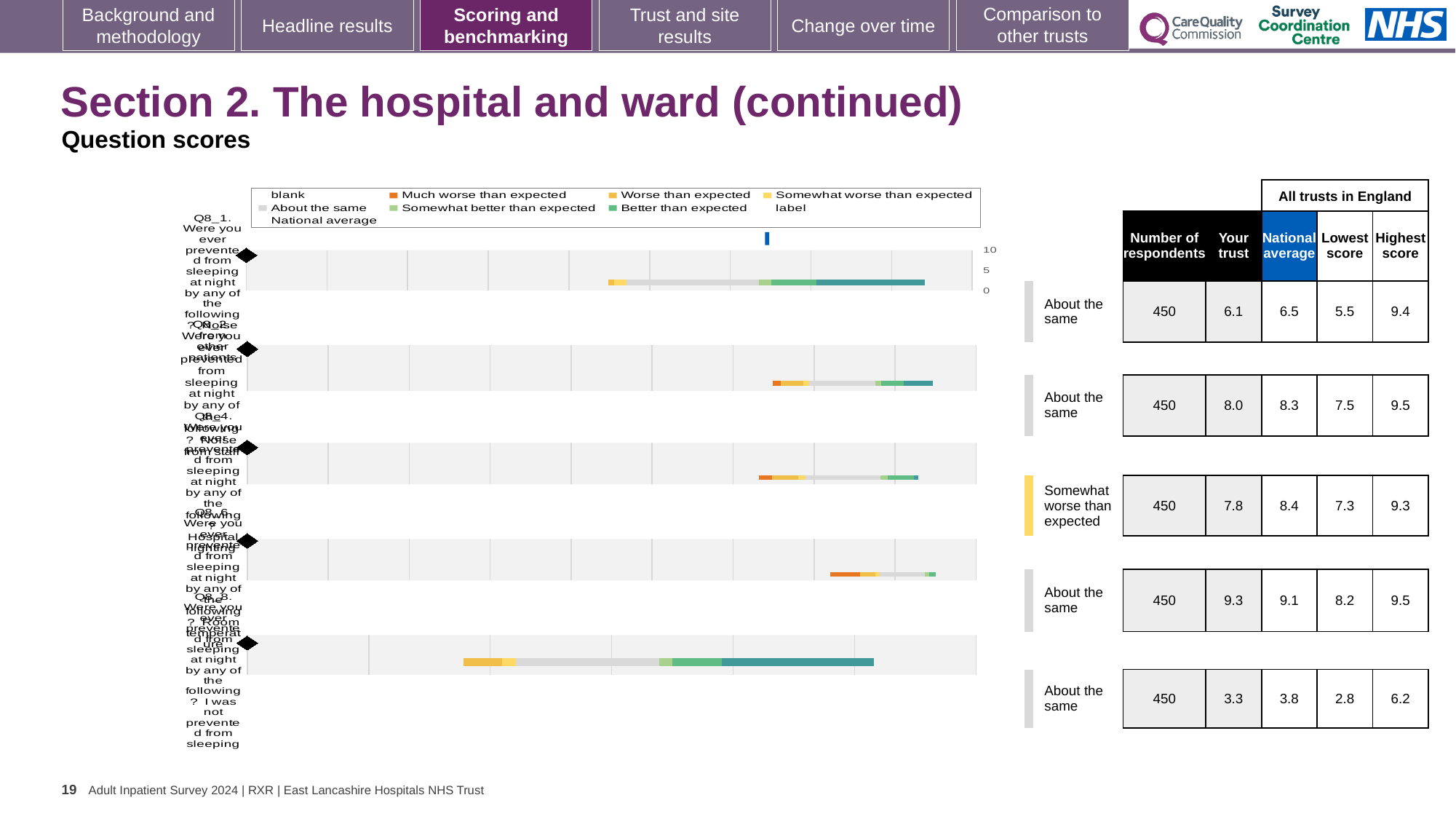
In the fourth row (Q8_6), which is larger: the 'Your trust' score or the national average? Your trust (9.3) How many respondents are listed for each row in the table? 450 In the table beside the chart, what is the 'Your trust' score for the first row (Q8_1)? 6.1 In the table beside the chart, what is the 'Your trust' score for the last row (Q8_8)? 3.3 How many question rows (bars) does the chart show? 5 In the table beside the chart, what is the highest score for the last row (Q8_8)? 6.2 In the table beside the chart, what is the national average for the first row (Q8_1)? 6.5 Which row in the table has the lowest 'Your trust' score? the last row (Q8_8), 3.3 Which benchmark label is shown for the third row (Q8_4)? Somewhat worse than expected Which row in the table has the highest 'Your trust' score? the fourth row (Q8_6), 9.3 What kind of chart is shown on the slide? bar chart What is the difference between the national average and the 'Your trust' score in the third row (Q8_4)? 0.6